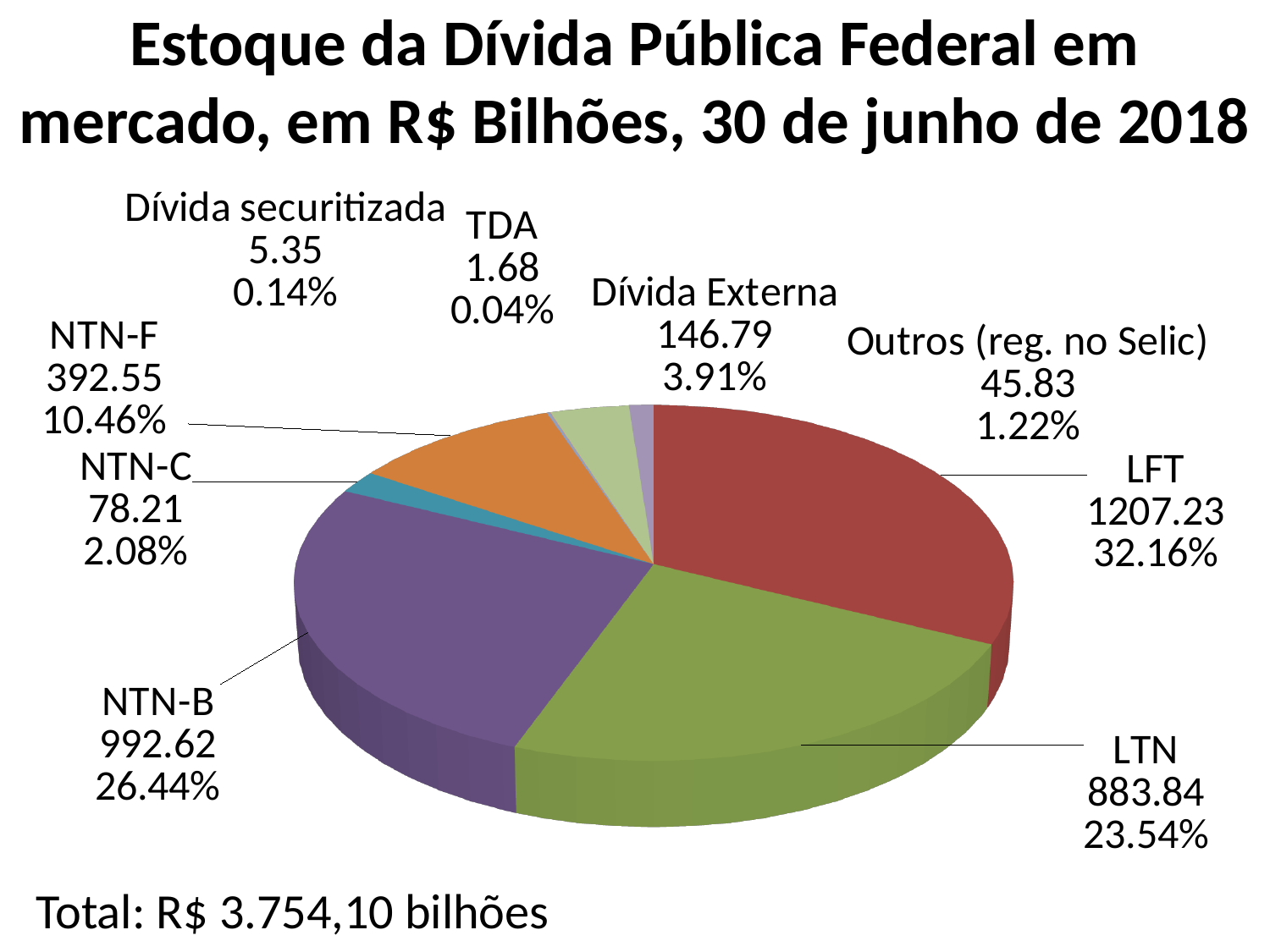
What type of chart is shown on the slide? Pie chart How many categories are shown in the pie chart? 9 What is the value for Dívida Externa? 146.79 What is the value for NTN-B? 992.62 Which is larger, the value for NTN-B or the value for LTN? NTN-B Which category has the largest slice of the pie? LFT What total is stated below the chart? R$ 3.754,10 bilhões What share of the pie does NTN-F represent? 10.46% What share of the pie does LTN represent? 23.54% Which category has the smallest slice of the pie? TDA What is the difference between the values for LFT and LTN? 323.39 What is the value for LFT? 1207.23